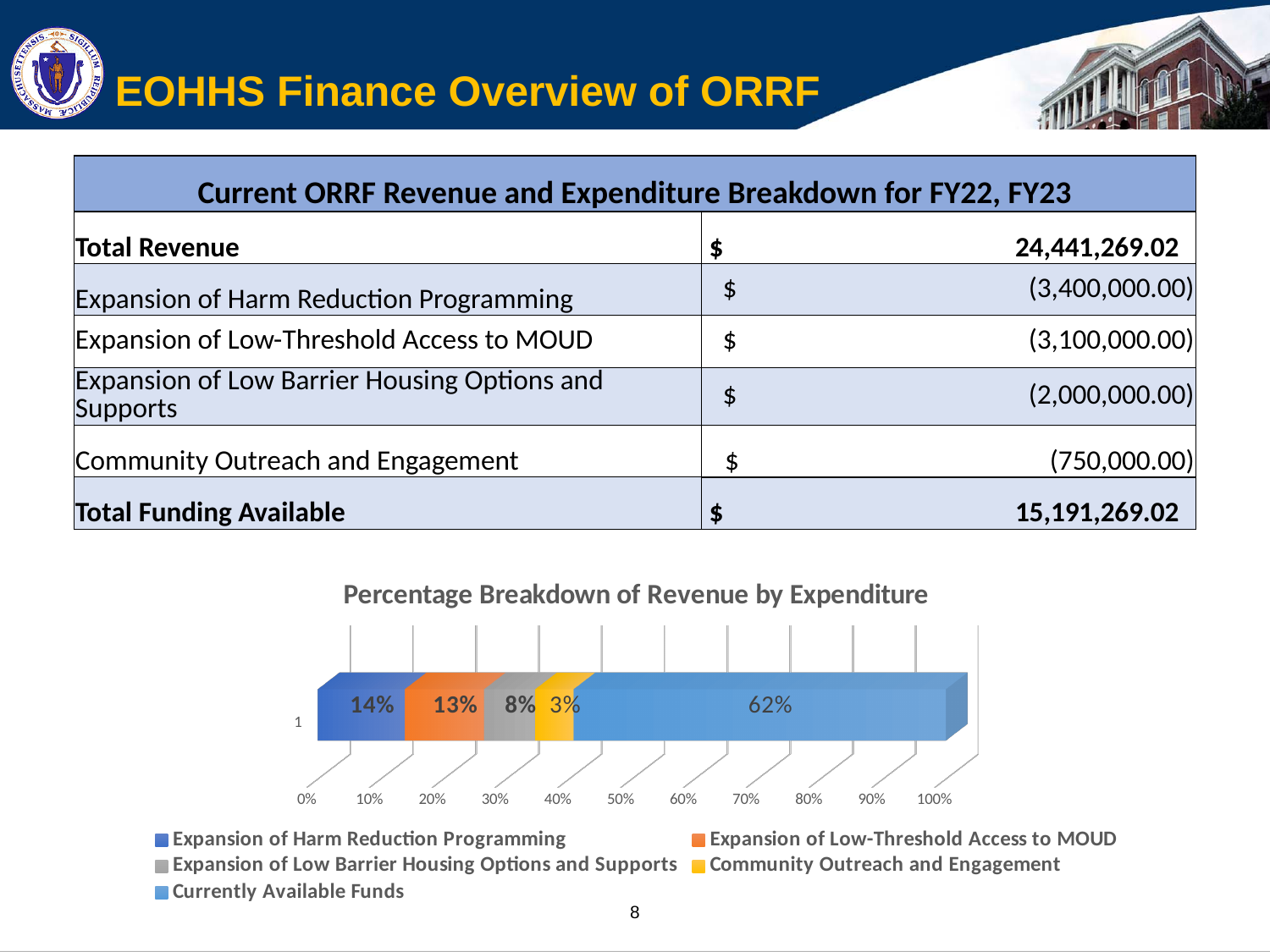
Which series has the smallest share in the chart? Community Outreach and Engagement What is the difference between the Currently Available Funds share and the Expansion of Harm Reduction Programming share in the chart? 48% What percentage does the chart show for Expansion of Harm Reduction Programming? 14% What kind of chart is shown on the slide? stacked bar chart What percentage does the chart show for Expansion of Low-Threshold Access to MOUD? 13% What percentage does the chart show for Currently Available Funds? 62% How many series does the chart legend list? 5 Which series has the largest share in the chart? Currently Available Funds What is the total of all segments in the stacked bar? 100% What is the title of the chart on the slide? Percentage Breakdown of Revenue by Expenditure What percentage does the chart show for Expansion of Low Barrier Housing Options and Supports? 8% What percentage does the chart show for Community Outreach and Engagement? 3%